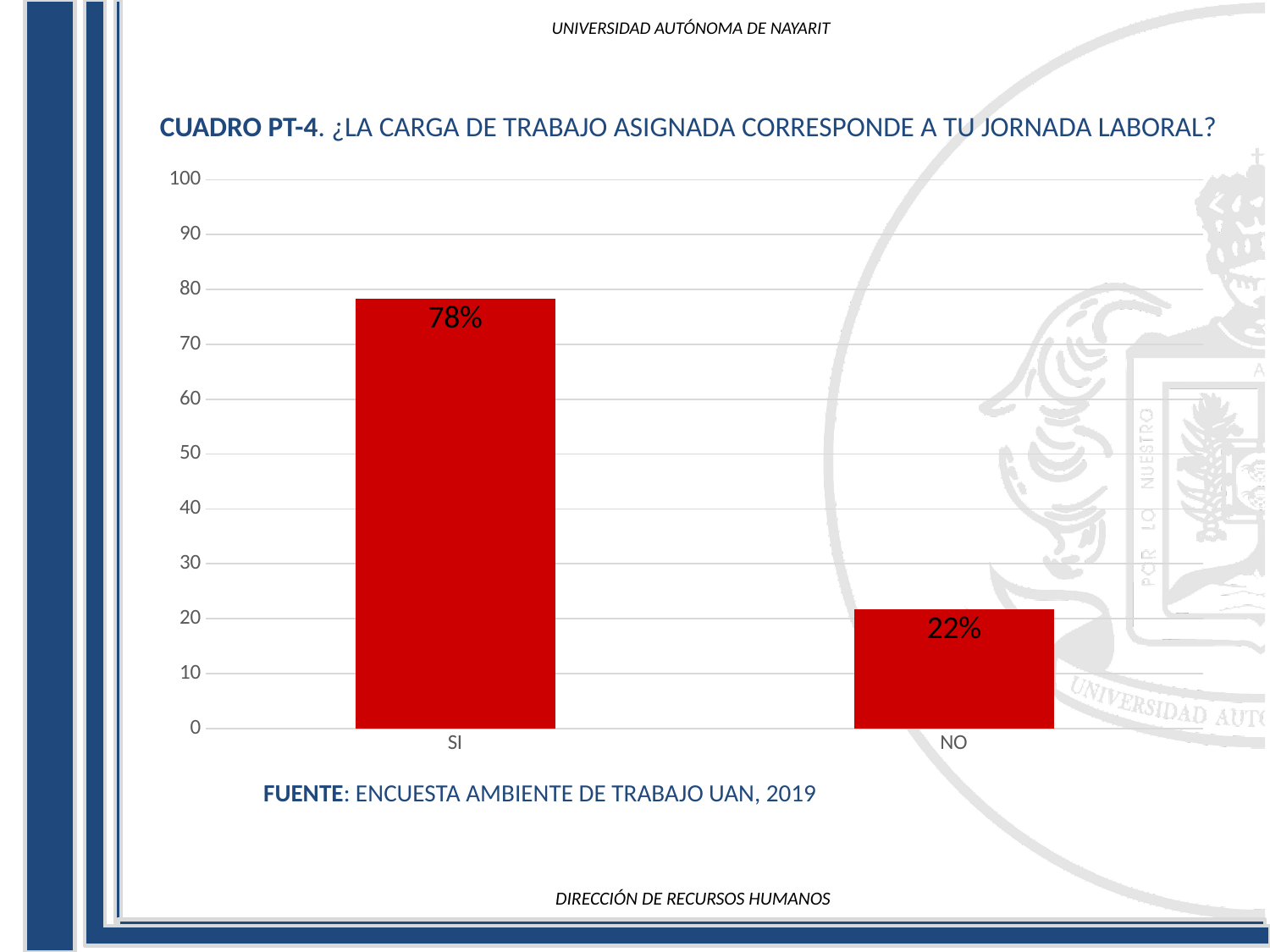
What colour are the bars in the chart? red Which category has the highest value? SI What is the value for NO? 22% What kind of chart is shown on the slide? bar chart Is the value for SI greater or less than 70? greater Which category has the lowest value? NO How many categories are shown on the x axis? 2 What is the title of the chart? CUADRO PT-4. ¿LA CARGA DE TRABAJO ASIGNADA CORRESPONDE A TU JORNADA LABORAL? What is the difference between the values for SI and NO? 56% What is the value for SI? 78% Which is larger, the value for SI or the value for NO? SI Is the value for NO greater or less than 30? less